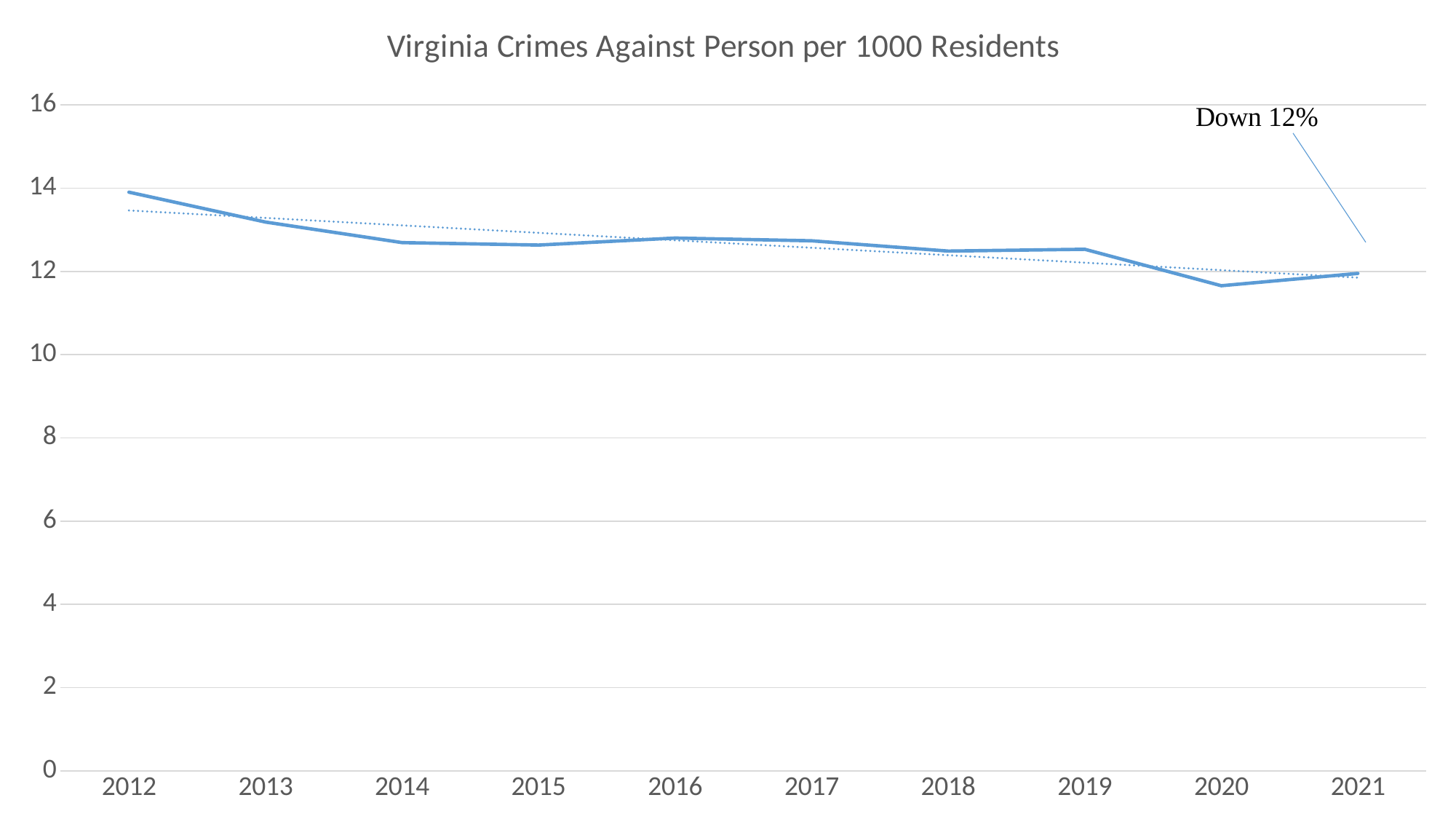
Which year has the lowest value? 2020 How many years are plotted along the x axis? 10 What does the annotation near the end of the line say? Down 12% Which is larger, the value for 2013 or the value for 2018? 2013 Is the value for 2012 greater or less than 12? greater Is the value for 2020 greater or less than 12? less Overall, do the values rise or fall from 2012 to 2021? fall What kind of chart is shown on the slide? line chart What is the title of the chart? Virginia Crimes Against Person per 1000 Residents Which is larger, the value for 2012 or the value for 2020? 2012 Which year has the highest value? 2012